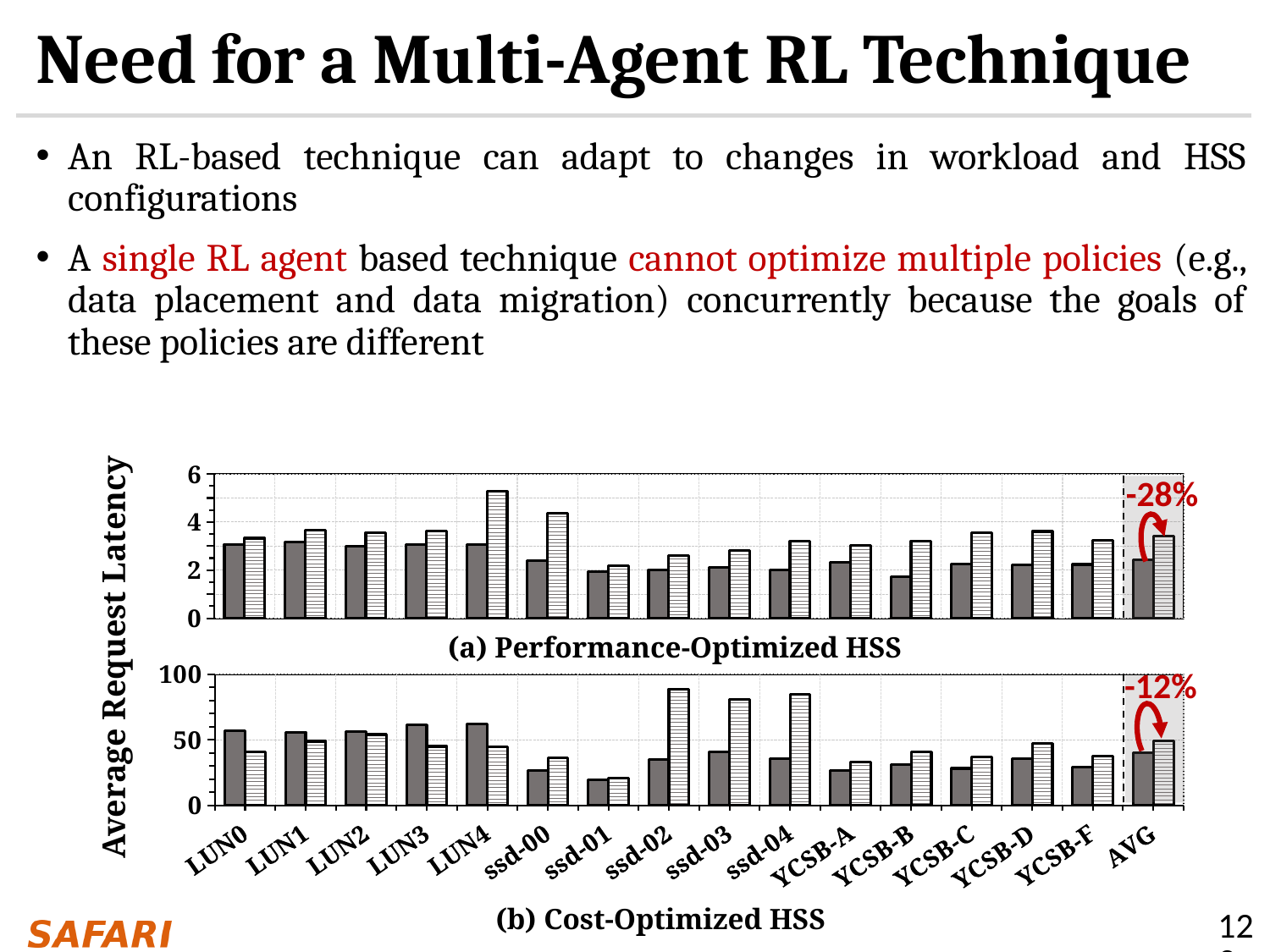
In the (a) Performance-Optimized HSS chart, for ssd-00, which bar is taller: the dark gray bar or the striped bar? the striped bar In the (b) Cost-Optimized HSS chart, what percentage change is annotated above the AVG bars? -12% In the (a) Performance-Optimized HSS chart, which category has the tallest striped bar? LUN4 In the (b) Cost-Optimized HSS chart, for LUN0, which bar is taller: the dark gray bar or the striped bar? the dark gray bar In the (b) Cost-Optimized HSS chart, which category has the shortest dark gray bar? ssd-01 In the (a) Performance-Optimized HSS chart, is the dark gray bar for YCSB-B greater or less than 2? less What kind of chart is shown in panel (a) Performance-Optimized HSS? bar chart In the (b) Cost-Optimized HSS chart, is the striped bar for ssd-02 greater or less than 50? greater In the (b) Cost-Optimized HSS chart, is the dark gray bar for ssd-01 greater or less than 50? less How many workload categories are shown along the x axis of the (b) Cost-Optimized HSS chart? 16 In the (a) Performance-Optimized HSS chart, what percentage change is annotated above the AVG bars? -28%